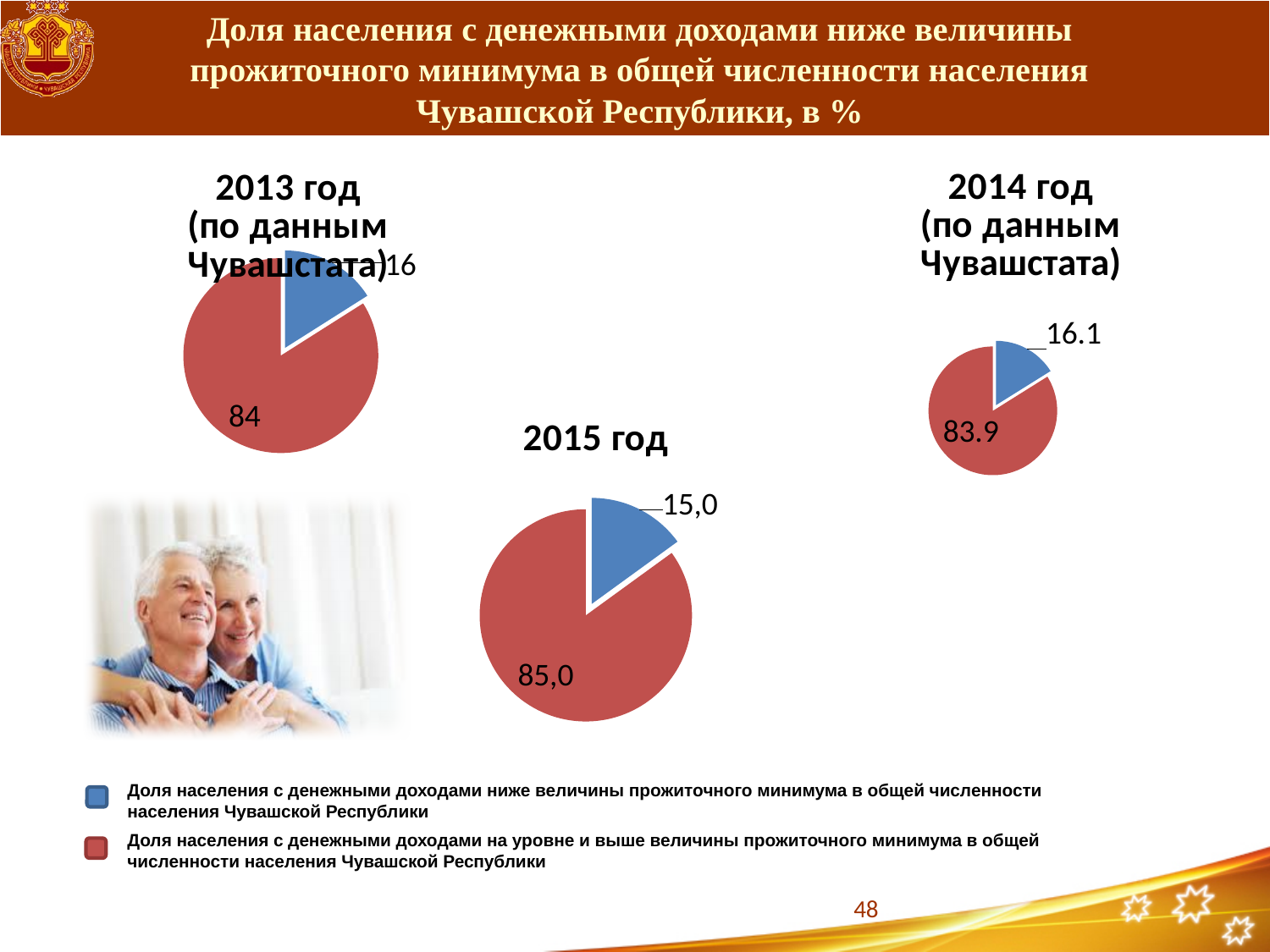
In the 2015 год pie chart, which slice is larger, the blue one or the red one? The red one How many pie charts are shown on the slide? 3 In the 2015 год pie chart, what value is shown for the red slice? 85,0 Which year's pie chart shows the smallest blue slice (share below the subsistence minimum)? 2015 год In the 2015 год pie chart, what value is shown for the blue slice? 15,0 In the 2013 год pie chart, what value is shown for the blue slice (share of population with incomes below the subsistence minimum)? 16 What type of chart is used for the 2015 год data? Pie chart How many entries does the legend at the bottom of the slide list? 2 In the 2014 год pie chart, what value is shown for the blue slice? 16.1 In the 2014 год pie chart, what is the difference between the red slice value and the blue slice value? 67.8 In the 2013 год pie chart, what value is shown for the red slice (share with incomes at or above the subsistence minimum)? 84 In the 2014 год pie chart, what value is shown for the red slice? 83.9